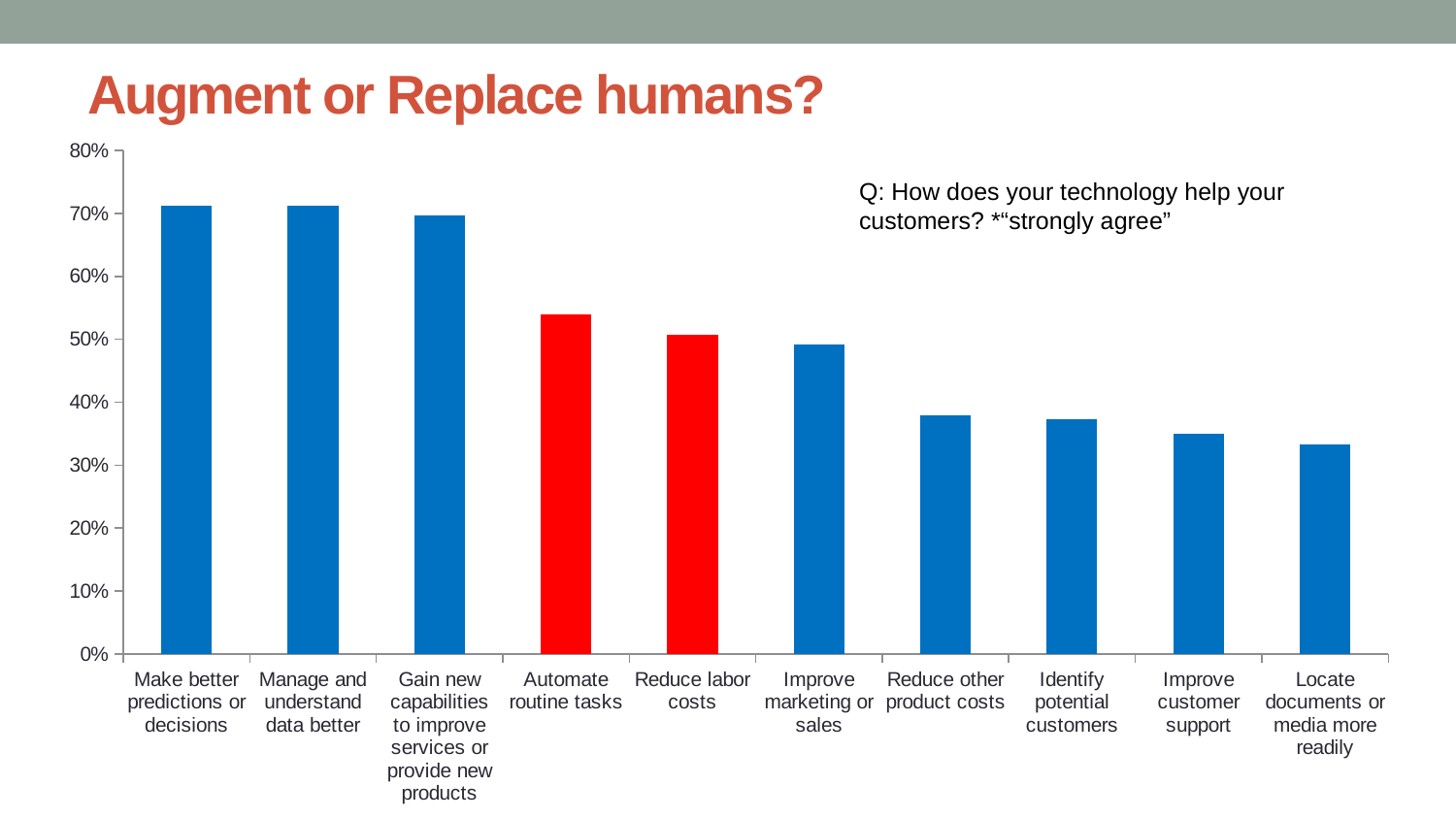
Which is larger, the value for "Gain new capabilities to improve services or provide new products" or the value for "Automate routine tasks"? Gain new capabilities to improve services or provide new products Is the value for "Reduce other product costs" greater or less than 40%? less Which two categories are shown with red bars? Automate routine tasks and Reduce labor costs Is the value for "Improve marketing or sales" greater or less than 40%? greater Is the value for "Locate documents or media more readily" greater or less than 30%? greater What kind of chart is shown on the slide? bar chart What is the title of the slide? Augment or Replace humans? How many categories are plotted on the chart? 10 Do the bar values generally rise or fall from left to right along the x axis? fall